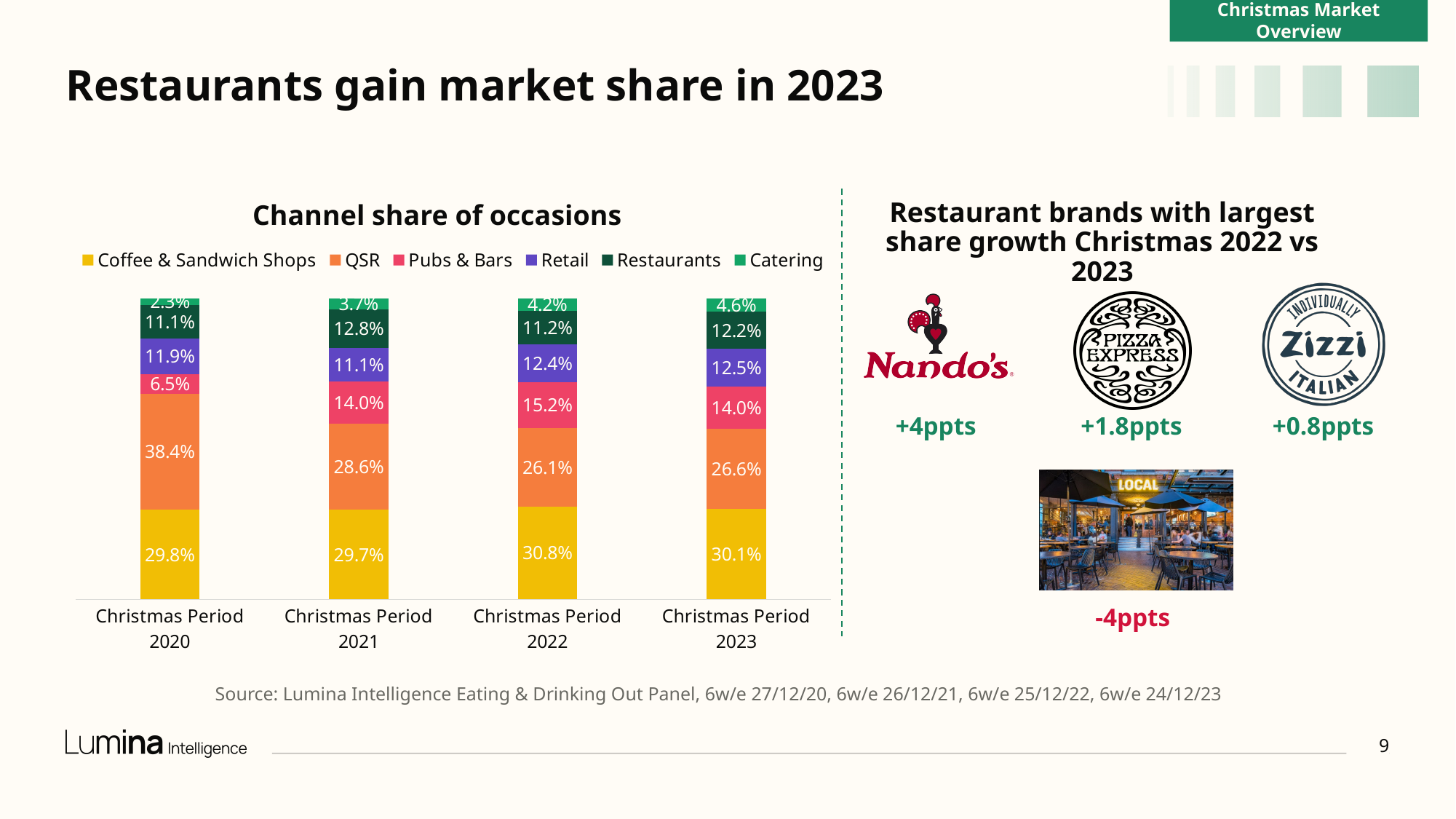
How many series does the legend of the 'Channel share of occasions' chart list? 6 Which is larger in Christmas Period 2023: the Retail share or the Restaurants share? Retail What is the Restaurants share of occasions in Christmas Period 2023? 12.2% What type of chart is 'Channel share of occasions'? Stacked bar chart How many Christmas periods are shown on the x axis of the 'Channel share of occasions' chart? 4 Which colour represents Coffee & Sandwich Shops in the 'Channel share of occasions' chart? Yellow Does the Catering share of occasions rise or fall from Christmas Period 2020 to Christmas Period 2023? Rise What is the Pubs & Bars share of occasions in Christmas Period 2022? 15.2% What is the difference between the QSR share in Christmas Period 2020 and Christmas Period 2021? 9.8 percentage points In which Christmas period is the Pubs & Bars share of occasions lowest? Christmas Period 2020 What is the QSR share of occasions in Christmas Period 2020? 38.4% In which Christmas period is the Catering share of occasions highest? Christmas Period 2023